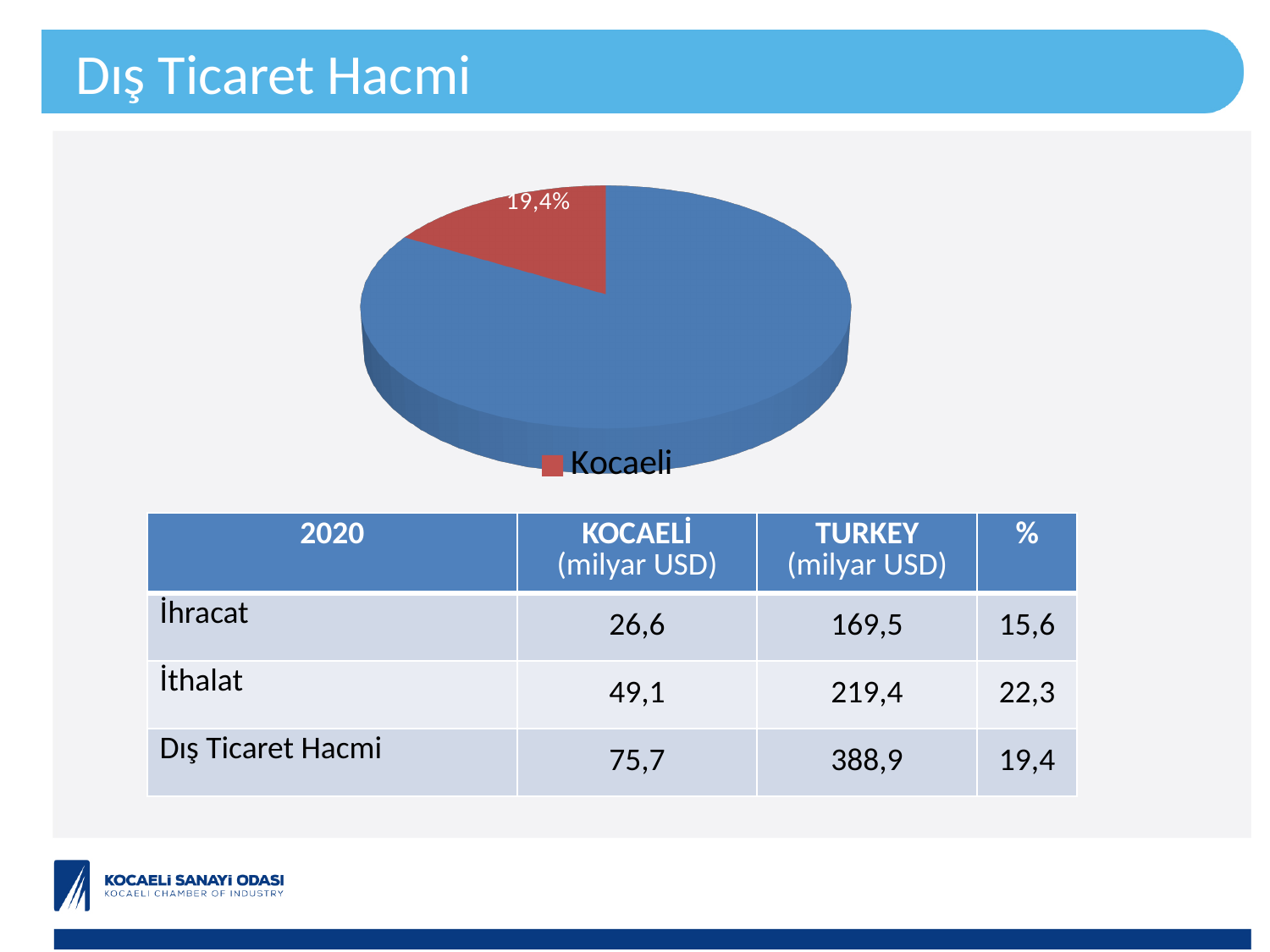
How many entries does the pie chart's legend list? 1 Is the Kocaeli share in the pie chart greater or less than 25%? less What is the value printed on the Kocaeli slice of the pie chart? 19,4% What kind of chart is shown on the slide? pie chart What is the only entry shown in the pie chart's legend? Kocaeli What share of the pie does the Kocaeli slice represent? 19,4% What colour is the Kocaeli slice in the pie chart? red How many slices does the pie chart have? 2 Is the Kocaeli slice the larger or the smaller slice of the pie chart? smaller